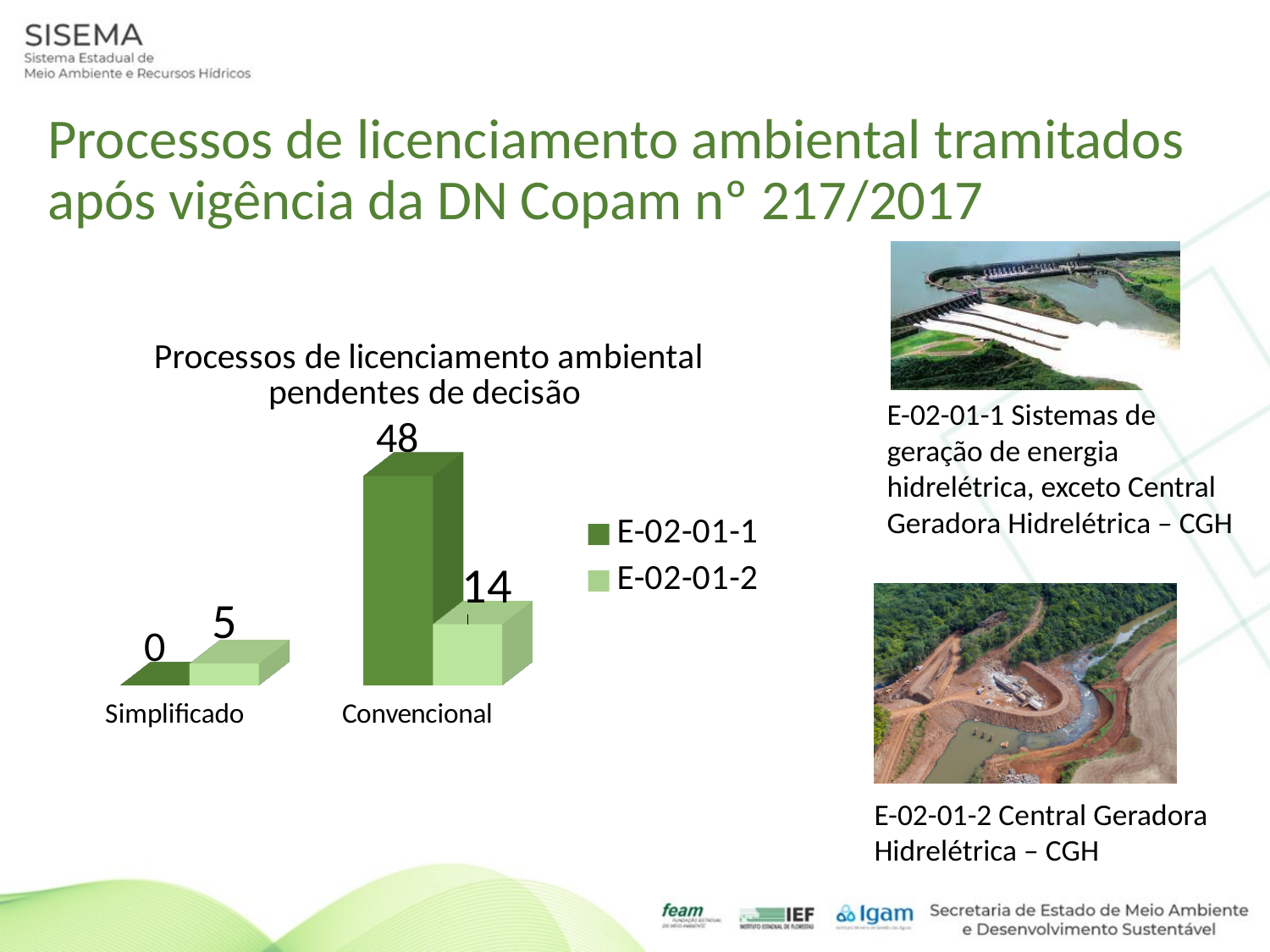
Which category has the highest value for E-02-01-1? Convencional Which category has the lowest value for E-02-01-2? Simplificado How many series does the chart legend list? 2 What kind of chart is shown on the slide? Bar chart What is the value for E-02-01-2 in the Simplificado category? 5 What is the title of the chart? Processos de licenciamento ambiental pendentes de decisão What is the value for E-02-01-1 in the Simplificado category? 0 Which is larger in the Simplificado category, E-02-01-1 or E-02-01-2? E-02-01-2 What is the value for E-02-01-2 in the Convencional category? 14 What is the difference between the E-02-01-1 and E-02-01-2 values in the Convencional category? 34 What is the value for E-02-01-1 in the Convencional category? 48 How many categories are shown on the x axis of the chart? 2